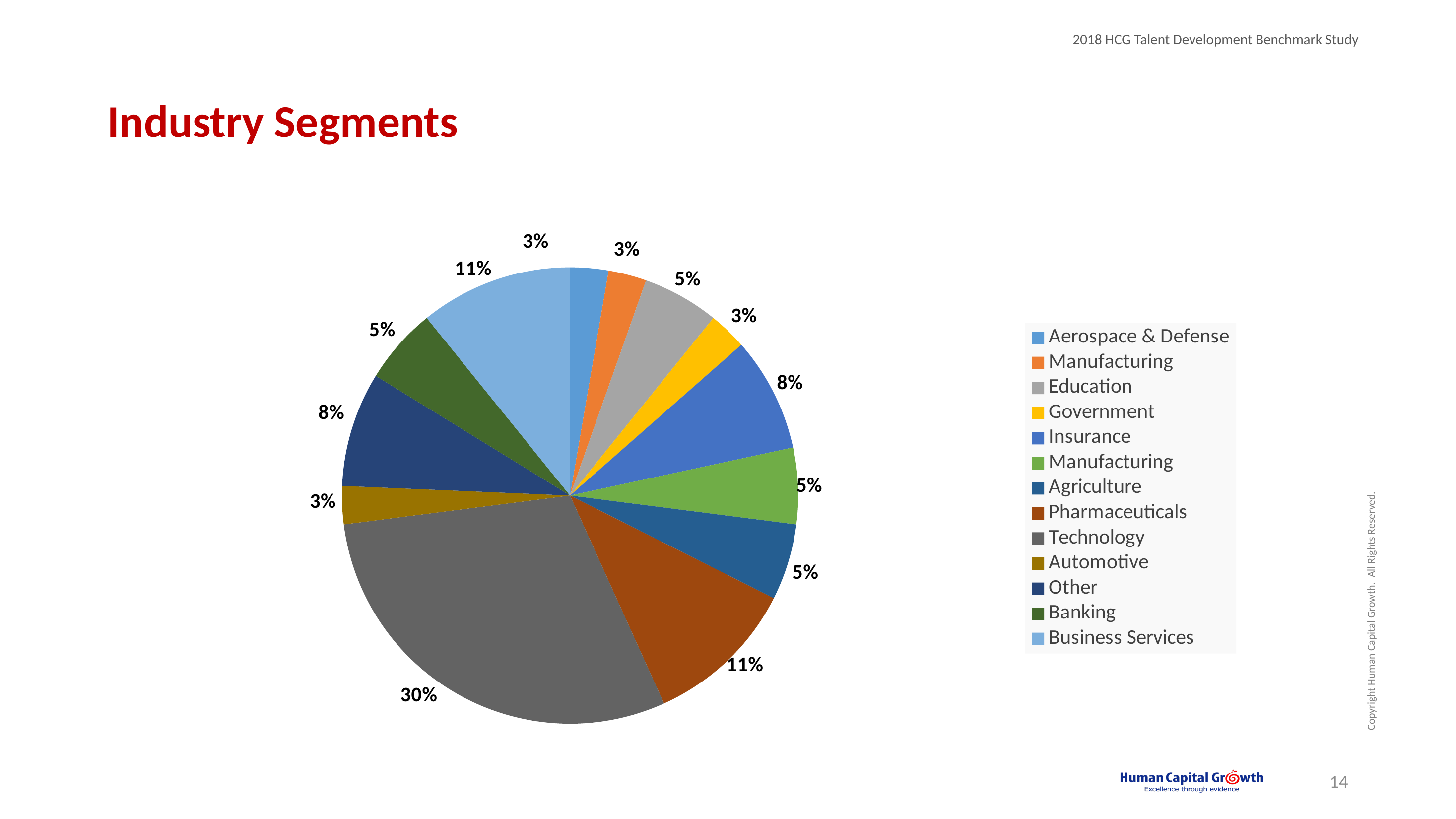
What percentage of the pie does Technology account for? 30% What kind of chart is shown on the slide? Pie chart Which industry segment has the largest share of the pie? Technology Which has a larger share, Insurance or Agriculture? Insurance What is the share for Automotive? 3% How many slices does the pie chart have? 13 What percentage is shown for Education? 5% What is the share for Business Services? 11% Which label appears twice in the chart's legend? Manufacturing How many percentage points larger is the Technology slice than the Pharmaceuticals slice? 19 percentage points What is the share for Pharmaceuticals? 11% What percentage is shown for Insurance? 8%